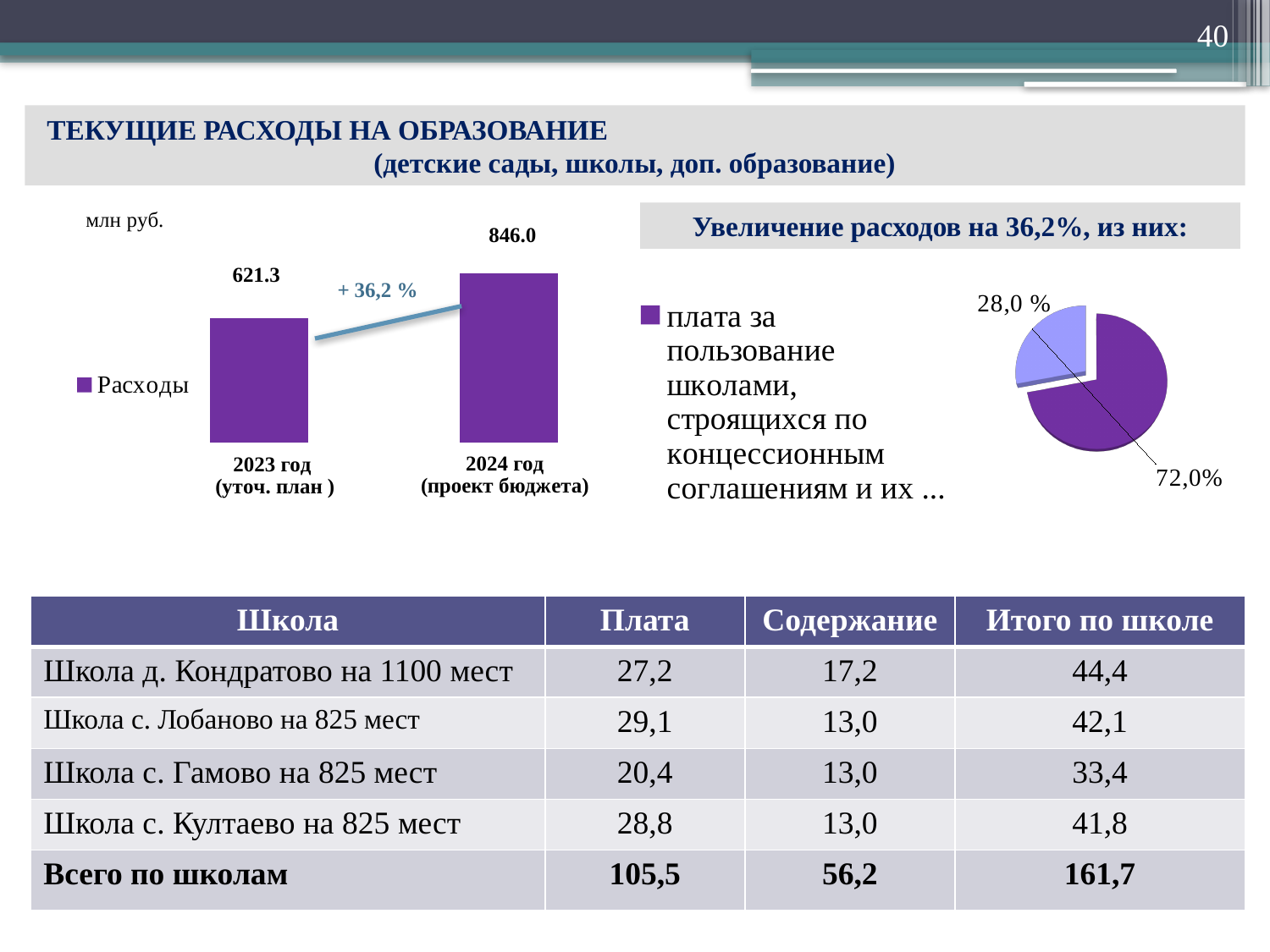
On the bar chart on the left, what is the difference between the 2024 and 2023 values? 224.7 On the bar chart on the left, do the values rise or fall from 2023 to 2024? rise On the pie chart on the right, what share does the larger (purple) slice have? 72,0% On the pie chart on the right, what share does the smaller (light blue) slice have? 28,0 % What type of chart is the chart on the left of the slide? bar chart On the bar chart on the left, what series name does the legend show? Расходы On the bar chart on the left, which year has the higher value? 2024 год (проект бюджета) On the bar chart on the left, what is the value for 2023 год (уточ. план)? 621.3 On the bar chart on the left, what percentage change is shown between the two bars? + 36,2 % On the bar chart on the left, how many bars are plotted? 2 What type of chart is the chart on the right of the slide? pie chart On the bar chart on the left, what is the value for 2024 год (проект бюджета)? 846.0